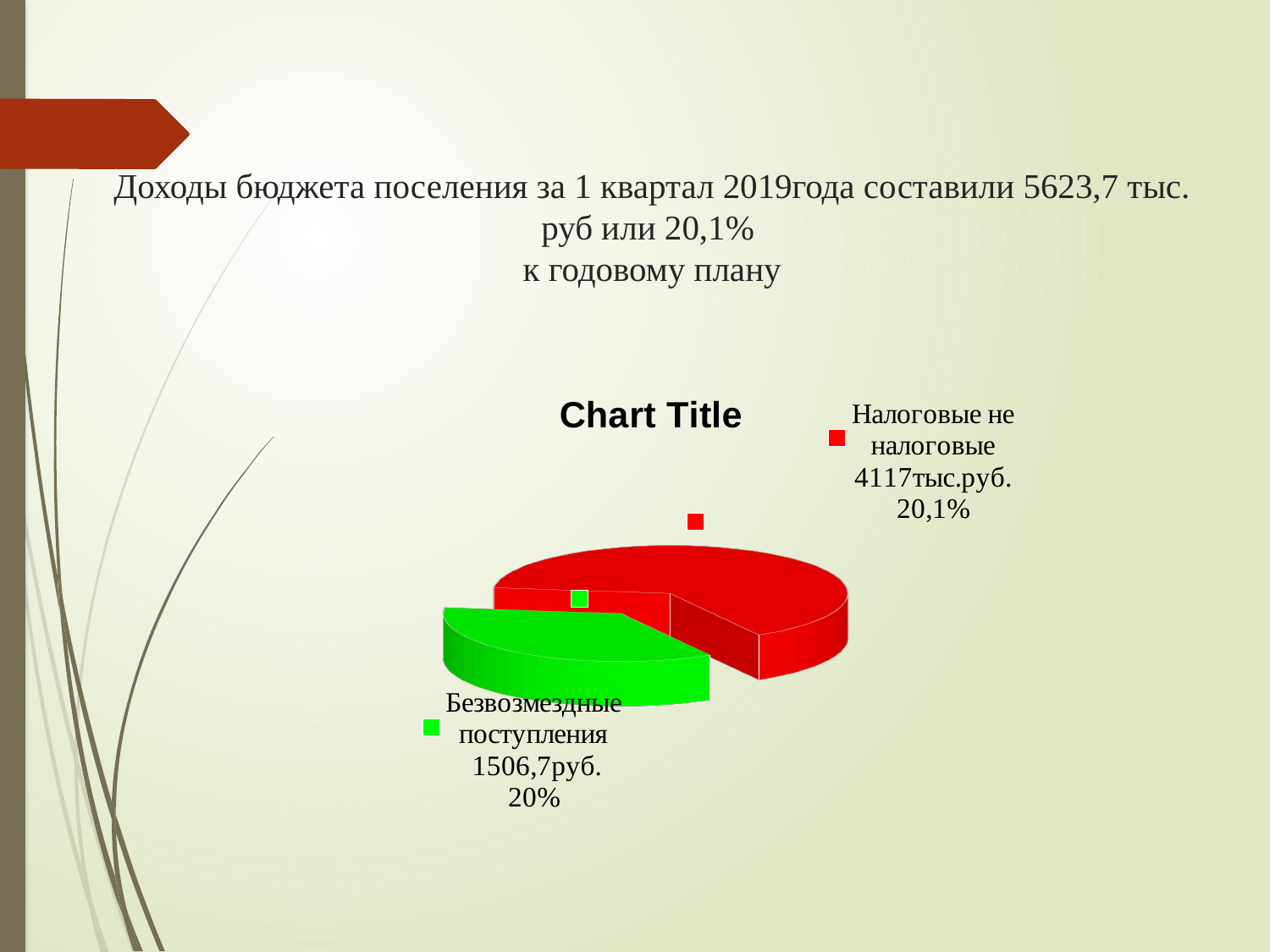
How many slices does the pie chart have? 2 What value is printed for the "Налоговые не налоговые" slice? 4117тыс.руб. What colour is the "Безвозмездные поступления" slice? green What percentage is printed next to "Налоговые не налоговые"? 20,1% What is the title of the chart? Chart Title Which is larger: "Налоговые не налоговые" or "Безвозмездные поступления"? Налоговые не налоговые Which slice of the pie chart is the largest? Налоговые не налоговые What kind of chart is shown on the slide? pie chart What is the sum of the two slice values, 4117 and 1506,7? 5623,7 Which slice of the pie chart is the smallest? Безвозмездные поступления What value is printed for the "Безвозмездные поступления" slice? 1506,7руб. What percentage is printed next to "Безвозмездные поступления"? 20%